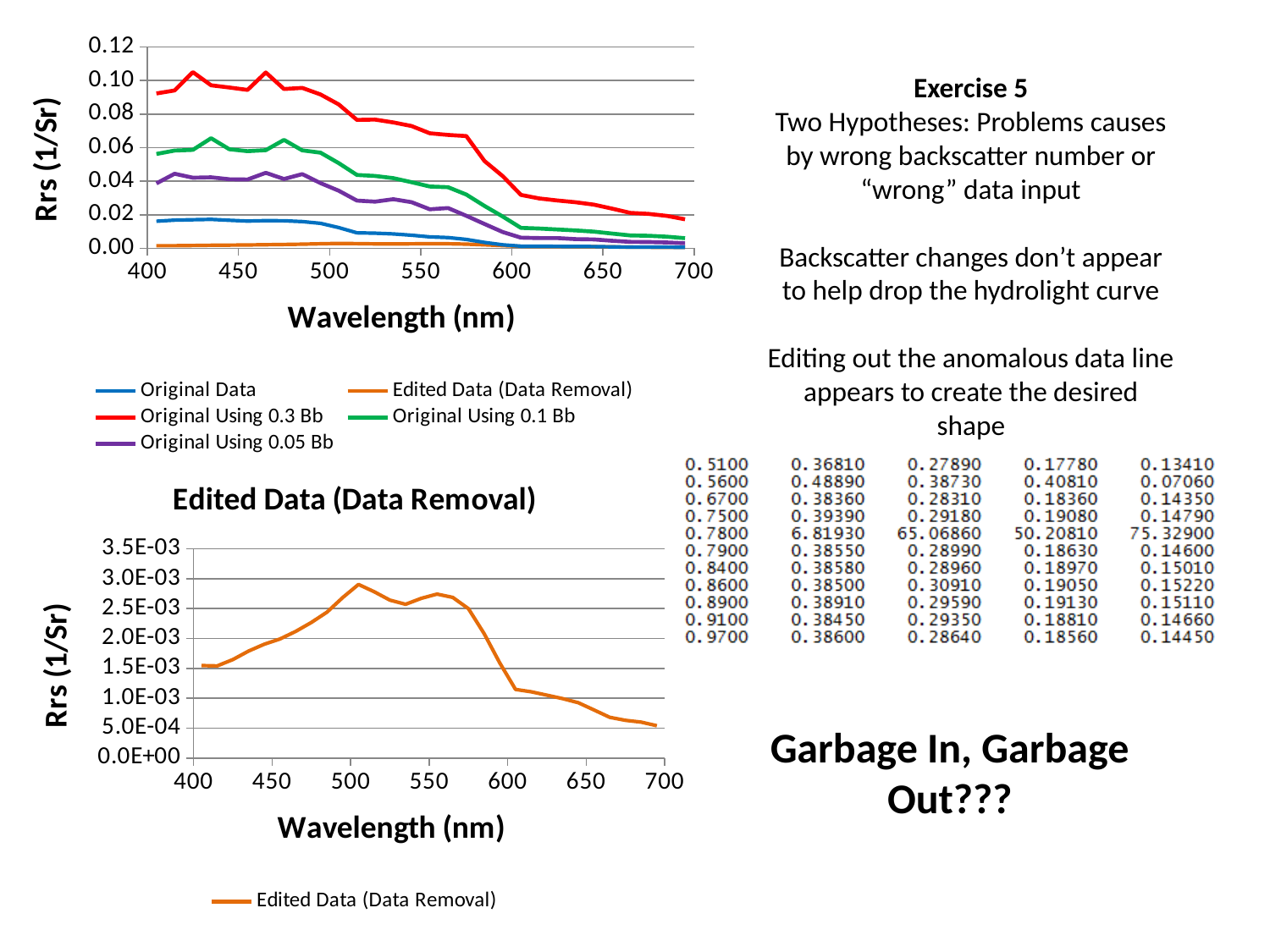
What type of chart is the top chart on the slide? line chart In the top chart, do the values of Original Using 0.3 Bb generally rise or fall as wavelength increases from 500 nm to 700 nm? fall In the top chart, which series has the lowest values across the wavelength range? Edited Data (Data Removal) How many series does the legend of the top chart list? 5 In the top chart, is the value of Original Using 0.05 Bb at 600 nm greater or less than 0.02? less In the top chart, at 500 nm, which is larger: Original Using 0.1 Bb or Original Using 0.05 Bb? Original Using 0.1 Bb In the top chart, is the value of Original Using 0.3 Bb at 500 nm greater or less than 0.08? greater In the bottom chart 'Edited Data (Data Removal)', is the value at 500 nm greater or less than 2.5E-03? greater What is the title of the bottom chart? Edited Data (Data Removal) In the bottom chart 'Edited Data (Data Removal)', do the values rise or fall as wavelength increases from 400 nm to 500 nm? rise In the top chart, which series has the highest values across the wavelength range? Original Using 0.3 Bb